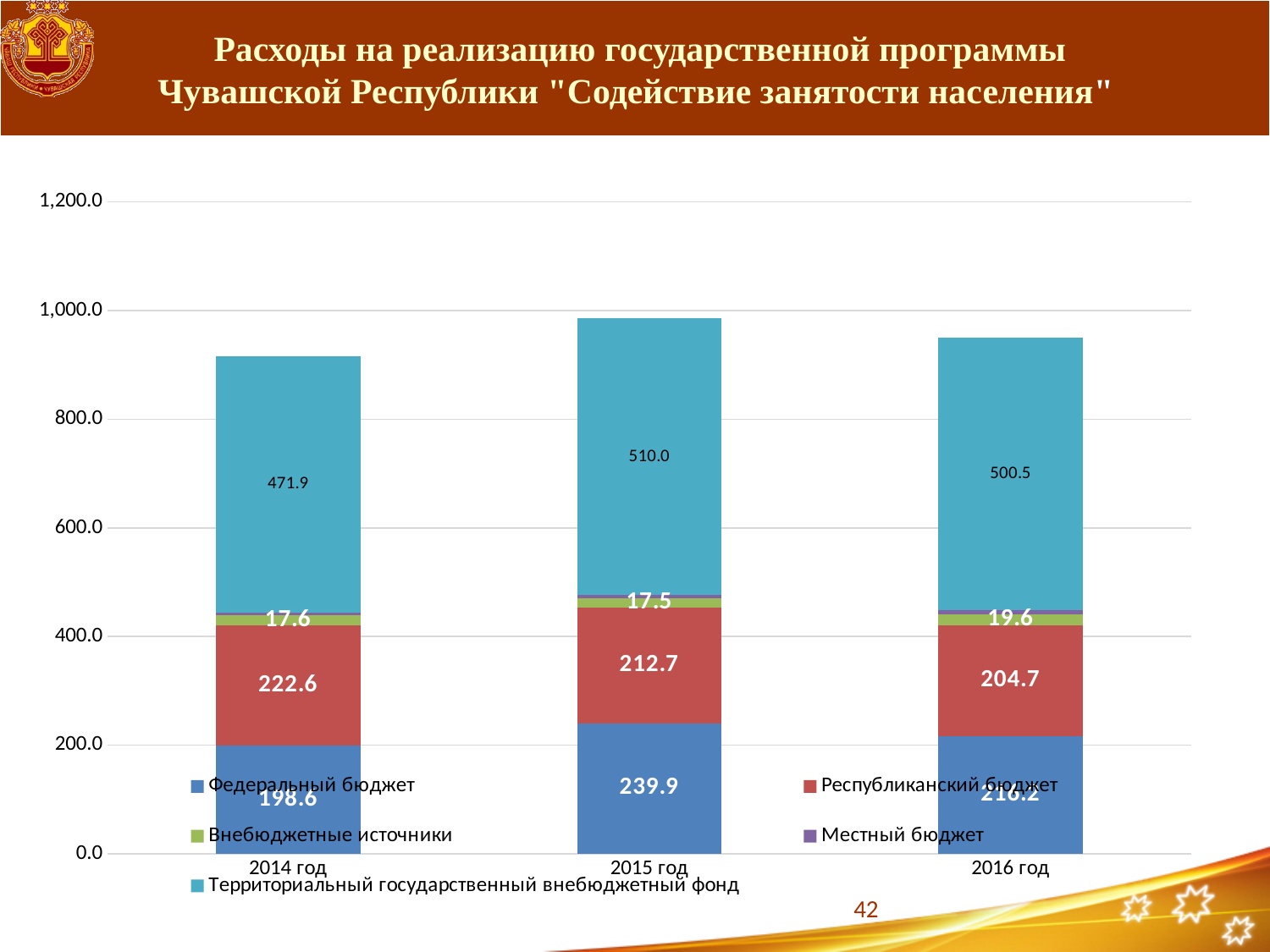
What is the value of Федеральный бюджет for 2015 год? 239.9 Which year has the larger Федеральный бюджет value, 2014 год or 2015 год? 2015 год What is the value of Внебюджетные источники for 2016 год? 19.6 Is the total height of the 2015 год bar greater or less than 800.0? greater What is the value of Республиканский бюджет for 2014 год? 222.6 What is the difference between the Территориальный государственный внебюджетный фонд values for 2015 год and 2014 год? 38.1 What kind of chart is shown on the slide? Stacked bar chart How many years (categories) are shown on the x axis? 3 In which year is the Территориальный государственный внебюджетный фонд value the highest? 2015 год What is the value of Территориальный государственный внебюджетный фонд for 2015 год? 510.0 How many series does the legend list? 5 In which year is the Республиканский бюджет value the lowest? 2016 год